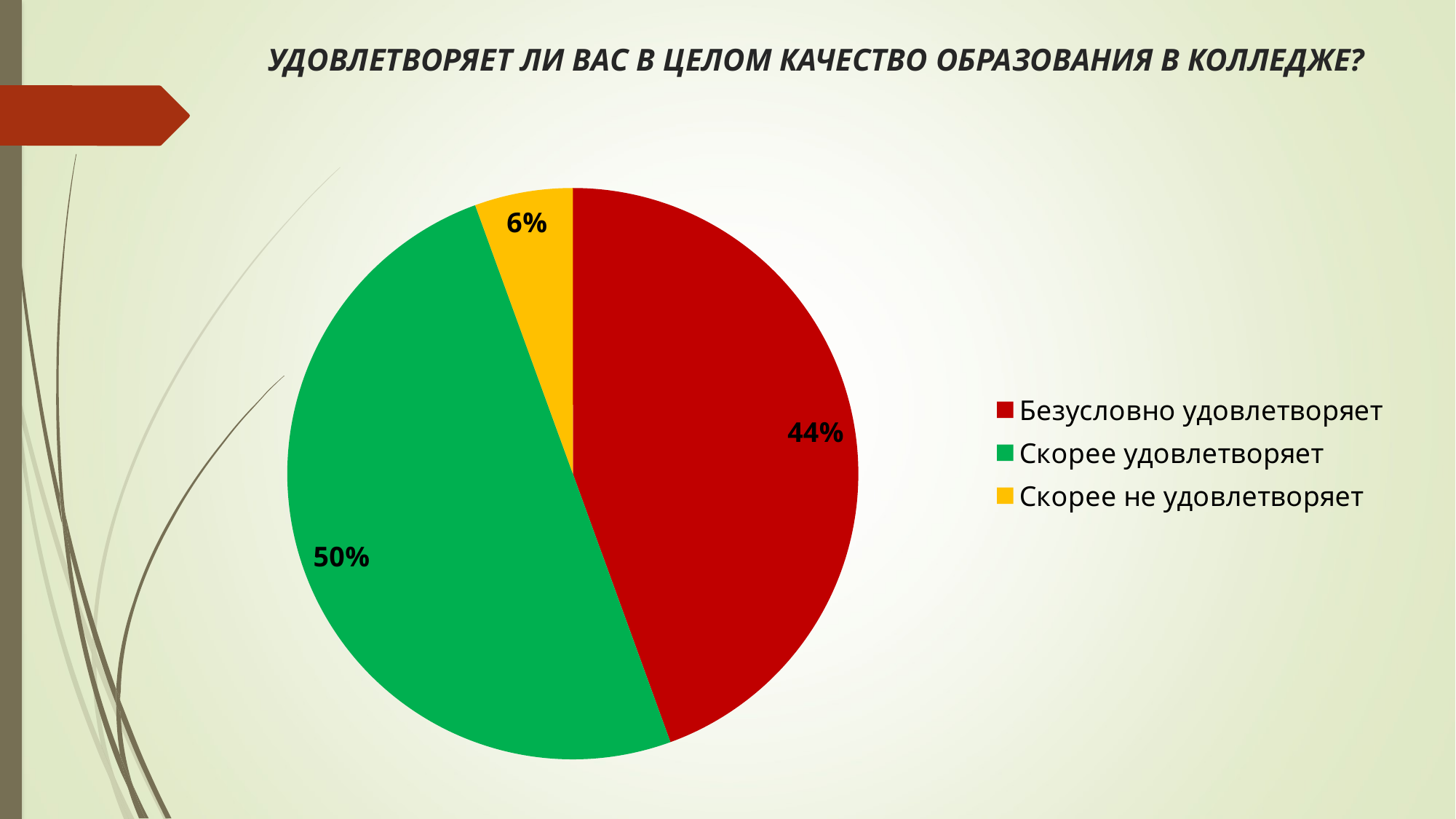
What kind of chart is shown on the slide? pie chart What is the title of the chart? УДОВЛЕТВОРЯЕТ ЛИ ВАС В ЦЕЛОМ КАЧЕСТВО ОБРАЗОВАНИЯ В КОЛЛЕДЖЕ? Which is larger: the share for "Безусловно удовлетворяет" or for "Скорее не удовлетворяет"? Безусловно удовлетворяет How many slices does the pie chart have? 3 What share of the pie does "Безусловно удовлетворяет" have? 44% What is the difference in percentage points between "Скорее удовлетворяет" and "Безусловно удовлетворяет"? 6 What share of the pie does "Скорее удовлетворяет" have? 50% Which category has the smallest share of the pie? Скорее не удовлетворяет Which category has the largest share of the pie? Скорее удовлетворяет What share of the pie does "Скорее не удовлетворяет" have? 6% What colour is the slice for "Скорее удовлетворяет"? green What is the difference in percentage points between "Безусловно удовлетворяет" and "Скорее не удовлетворяет"? 38